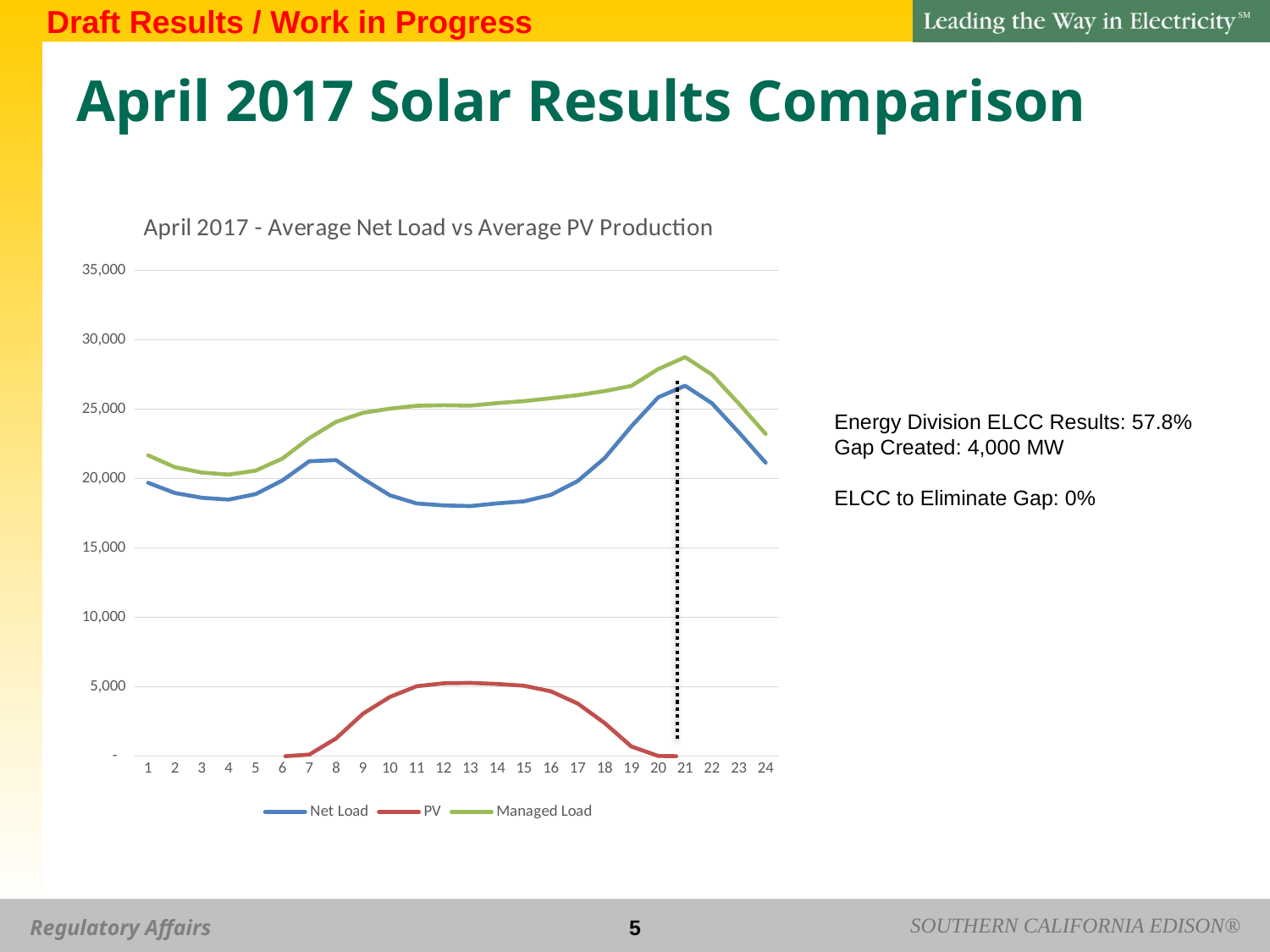
What kind of chart is shown on the slide? line chart Does the PV series rise or fall from hour 6 to hour 12? rise At hour 12, which is larger: Net Load or PV? Net Load Is the PV value at hour 12 greater or less than 10,000? less Is the Net Load value at hour 13 greater or less than 20,000? less Is the Managed Load value at hour 21 greater or less than 25,000? greater Does the Net Load series rise or fall from hour 21 to hour 24? fall At which hour does the Managed Load series reach its highest value? 21 How many hourly points are plotted along the x axis of the chart? 24 Which series is drawn in red in the chart? PV What is the title of the chart? April 2017 - Average Net Load vs Average PV Production How many series does the chart legend list? 3